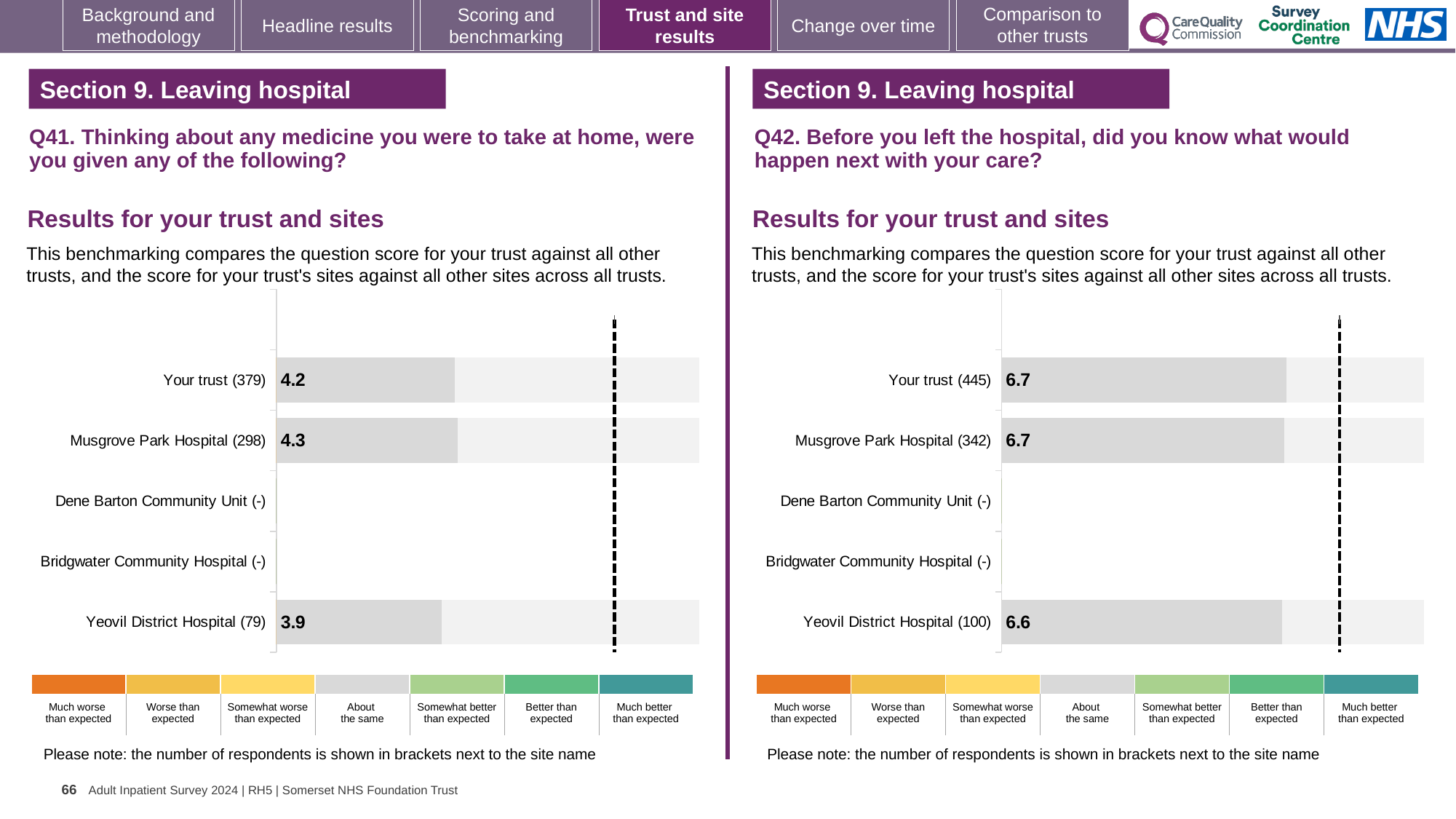
On the Q41 chart (left), what is the score for Your trust? 4.2 On the Q42 chart (right), what is the score for Your trust? 6.7 On the Q41 chart (left), what is the score for Musgrove Park Hospital? 4.3 How many site or trust rows are listed on the Q42 chart (right)? 5 On the Q42 chart (right), what is the score for Yeovil District Hospital? 6.6 On the Q42 chart (right), which has the larger score, Musgrove Park Hospital or Yeovil District Hospital? Musgrove Park Hospital On the Q41 chart (left), which site or trust row has the highest score? Musgrove Park Hospital On the Q41 chart (left), which site or trust row has the lowest score? Yeovil District Hospital On the Q42 chart (right), what is the difference between the scores for Your trust and Yeovil District Hospital? 0.1 On the Q41 chart (left), what is the score for Yeovil District Hospital? 3.9 What kind of chart is used on the Q41 chart (left)? Bar chart On the Q41 chart (left), what is the difference between the scores for Musgrove Park Hospital and Yeovil District Hospital? 0.4